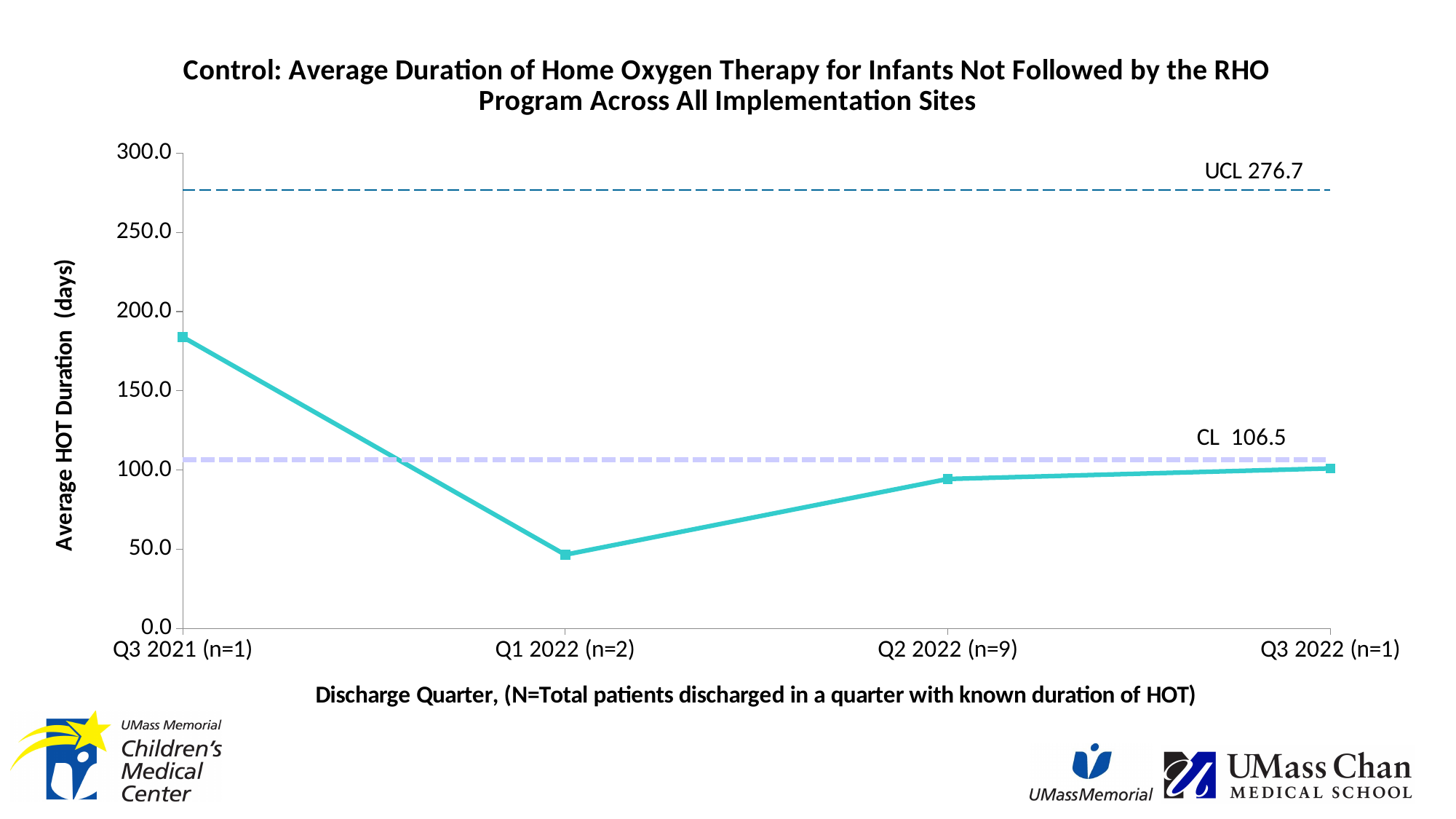
Does the average HOT duration rise or fall from Q3 2021 to Q1 2022? fall Is the average HOT duration for Q2 2022 (n=9) greater or less than 100.0 days? less Does the average HOT duration rise or fall from Q1 2022 to Q3 2022? rise What is the value of the upper control limit (UCL) shown on the chart? 276.7 Which has a larger average HOT duration, Q3 2021 (n=1) or Q2 2022 (n=9)? Q3 2021 (n=1) How many discharge quarters are plotted on the x axis? 4 What is the value of the center line (CL) shown on the chart? 106.5 Is the average HOT duration for Q1 2022 (n=2) greater or less than 50.0 days? less Which discharge quarter has the highest average HOT duration? Q3 2021 (n=1) What kind of chart is shown on the slide? line chart Is the average HOT duration for Q3 2021 (n=1) greater or less than 150.0 days? greater Which discharge quarter has the lowest average HOT duration? Q1 2022 (n=2)